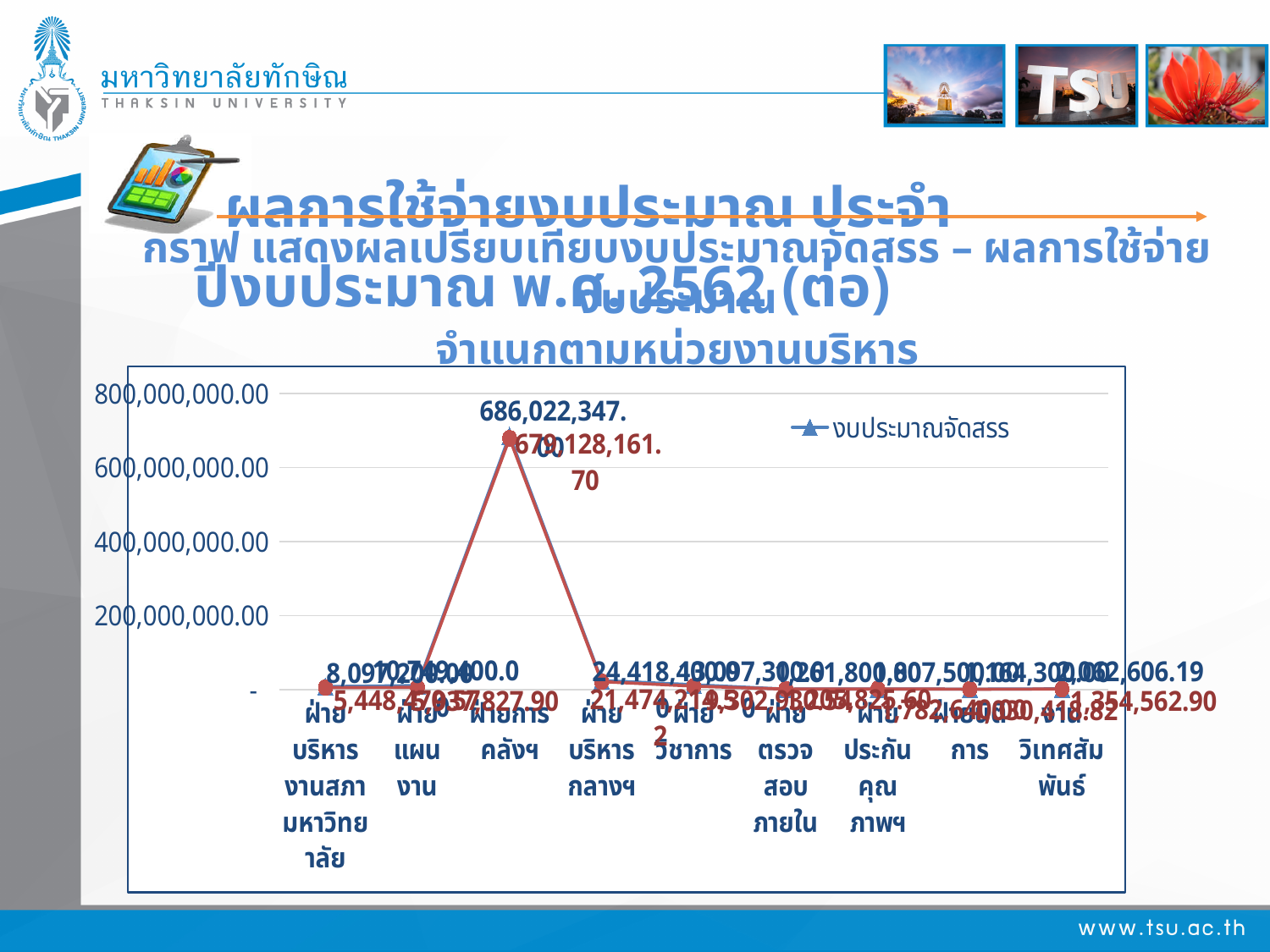
Which is larger, the value for ฝ่ายการคลังฯ or the value for ฝ่ายบริหารกลางฯ? ฝ่ายการคลังฯ Do the values rise or fall from ฝ่ายการคลังฯ to ฝ่ายบริหารกลางฯ? fall Is the value for ฝ่ายวิชาการ greater or less than 200,000,000.00? less What is the highest value shown on the y axis? 800,000,000.00 What is the งบประมาณจัดสรร value for ฝ่ายการคลังฯ? 686,022,347.00 What is the red-series (ผลการใช้จ่าย) value for ฝ่ายการคลังฯ? 679,128,161.70 Which series name is listed in the chart legend? งบประมาณจัดสรร Which unit has the highest งบประมาณจัดสรร value? ฝ่ายการคลังฯ What kind of chart is shown on the slide? line chart Is the งบประมาณจัดสรร value for ฝ่ายการคลังฯ greater or less than 600,000,000.00? greater How many administrative units (categories) are plotted along the x axis? 9 What is the difference between the two values shown for ฝ่ายการคลังฯ (686,022,347.00 and 679,128,161.70)? 6,894,185.30